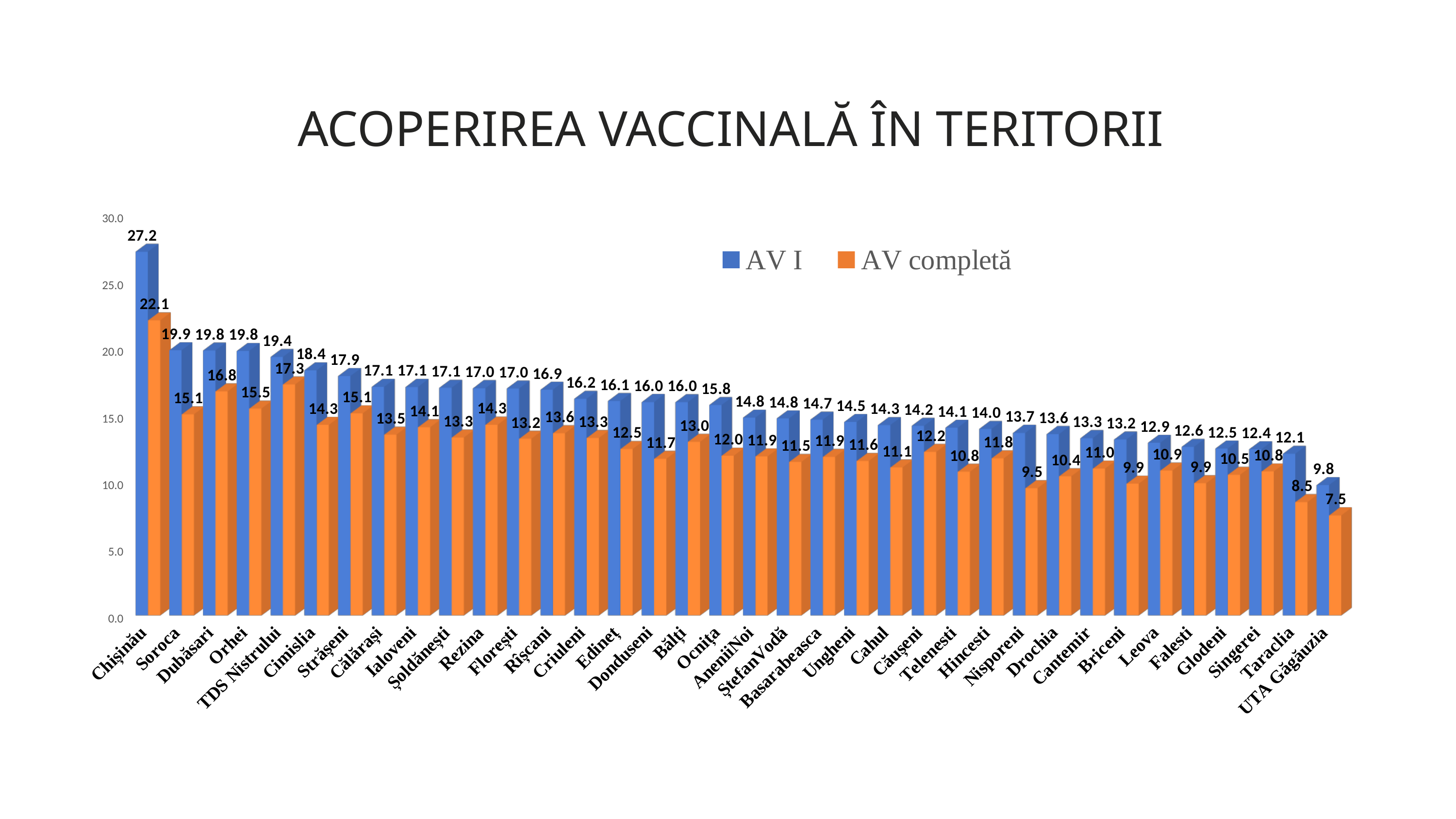
What is the difference between the AV I and AV completă values for Chișinău? 5.1 Which territory has the lowest AV completă value? UTA Găgăuzia What kind of chart is shown on the slide? bar chart Which is larger, the AV completă value for TDS Nistrului or for Dubăsari? TDS Nistrului Is the AV I value for Taraclia greater or less than 10.0? greater How many territories are shown on the x axis? 36 How many series does the legend list? 2 What is the AV completă value for UTA Găgăuzia? 7.5 What is the AV I value for Chișinău? 27.2 Which territory has the highest AV I value? Chișinău What is the AV completă value for Soroca? 15.1 Do the AV I values rise or fall from left to right along the x axis? fall